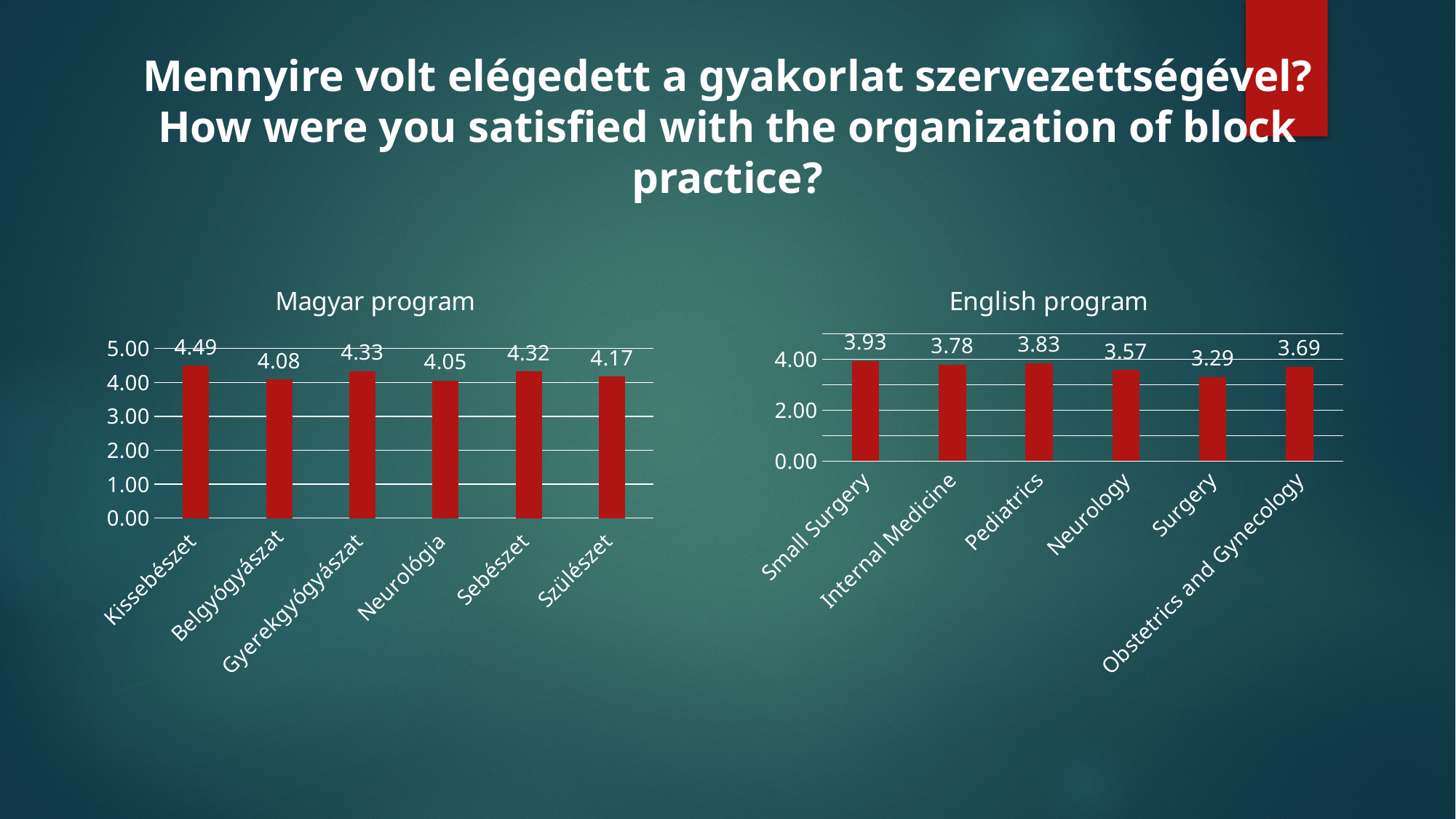
In the English program chart, which category has the highest value? Small Surgery In the Magyar program chart, what is the value for Neurológia? 4.05 In the English program chart, what is the value for Pediatrics? 3.83 In the Magyar program chart, what is the difference between Kissebészet and Belgyógyászat? 0.41 What type of chart is the Magyar program chart? Bar chart In the Magyar program chart, which category has the lowest value? Neurológia In the English program chart, what is the value for Obstetrics and Gynecology? 3.69 In the Magyar program chart, which category has the highest value? Kissebészet In the Magyar program chart, what is the value for Kissebészet? 4.49 How many categories are shown in the English program chart? 6 In the English program chart, which category has the lowest value? Surgery In the English program chart, which is larger, Internal Medicine or Neurology? Internal Medicine